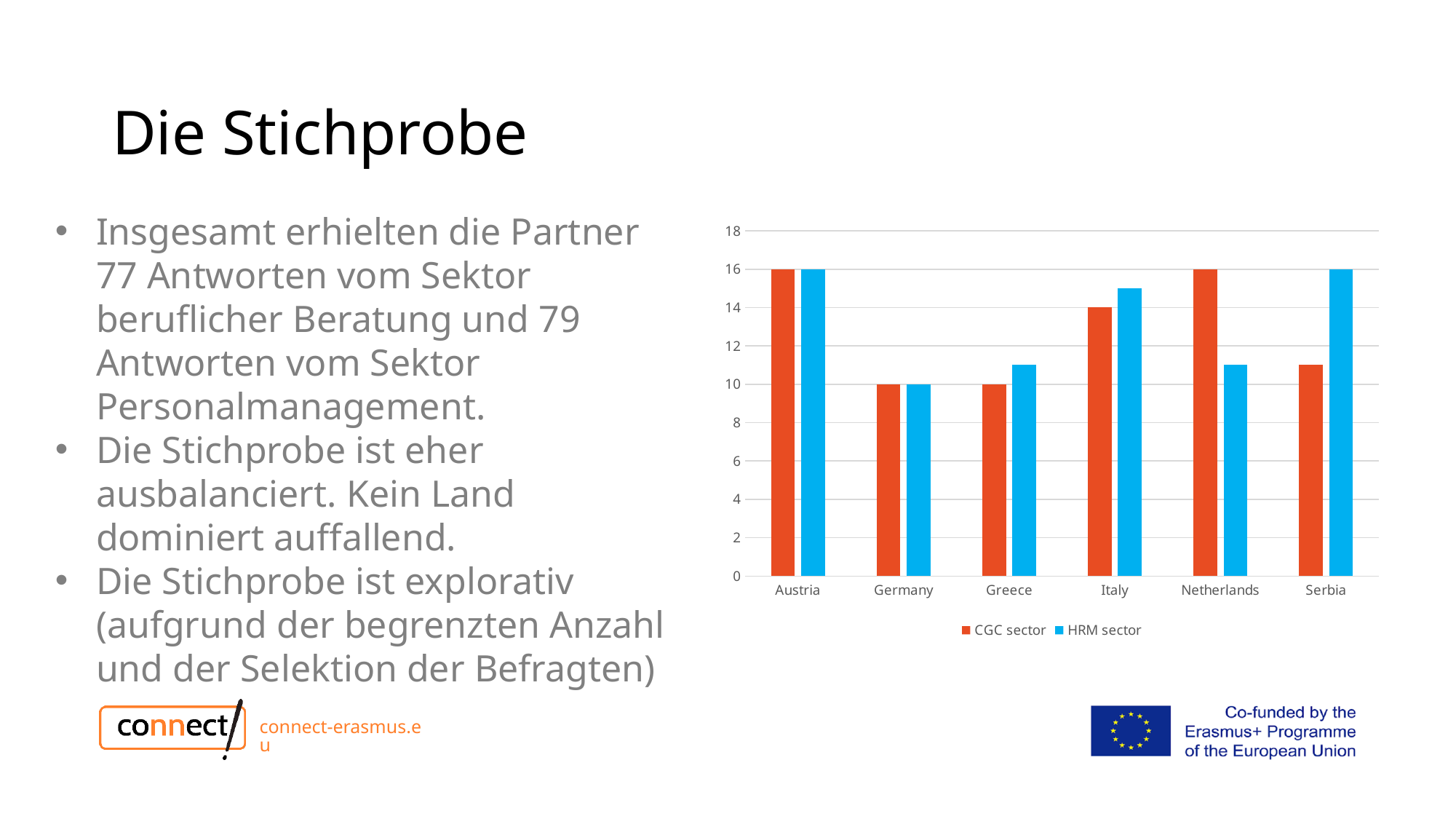
How many series does the chart legend list? 2 How many countries are shown on the x axis of the chart? 6 What kind of chart is shown on the slide? bar chart What is the HRM sector value for Germany? 10 What is the CGC sector value for Austria? 16 For the Netherlands, which is larger: the CGC sector or the HRM sector value? CGC sector What is the CGC sector value for Italy? 14 Which country has the highest HRM sector value? Austria and Serbia Which country has the lowest CGC sector value? Germany and Greece For Serbia, which is larger: the CGC sector or the HRM sector value? HRM sector Is the HRM sector value for Greece greater or less than 12? less Which colour represents the HRM sector in the chart? blue